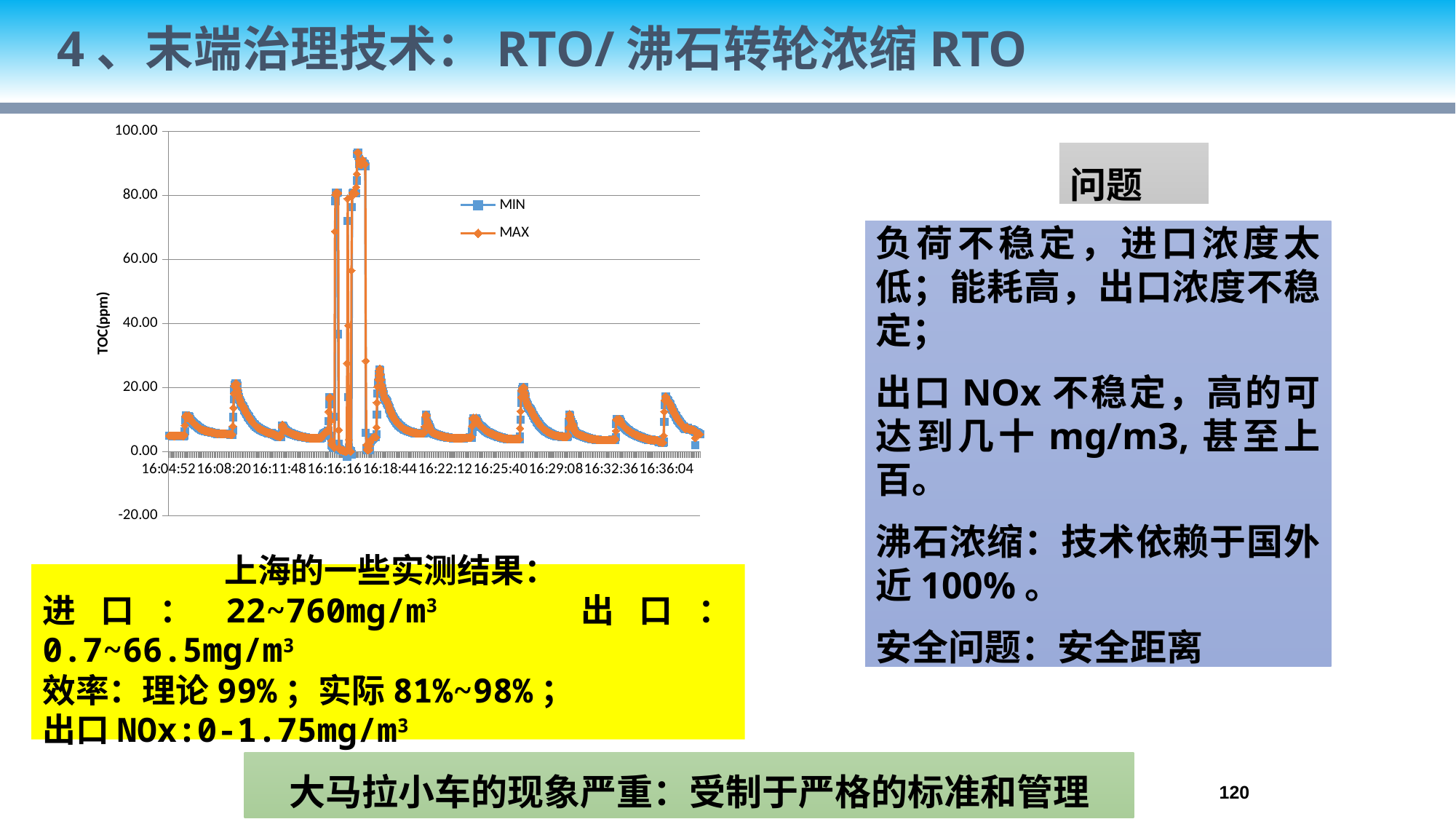
Is the value of the MIN series at 16:04:52 greater or less than 20? less What is the highest tick value shown on the vertical axis? 100.00 What are the two series named in the chart legend? MIN and MAX What is the first time label shown on the horizontal axis? 16:04:52 Is the value of the MAX series at 16:36:04 greater or less than 20? less How many series does the chart legend list? 2 Is the highest peak of the MAX series greater or less than 100? less What is the lowest tick value shown on the vertical axis? -20.00 What is the last time label shown on the horizontal axis? 16:36:04 What is the label on the vertical axis of the chart? TOC(ppm) What kind of chart is shown on the slide? line chart